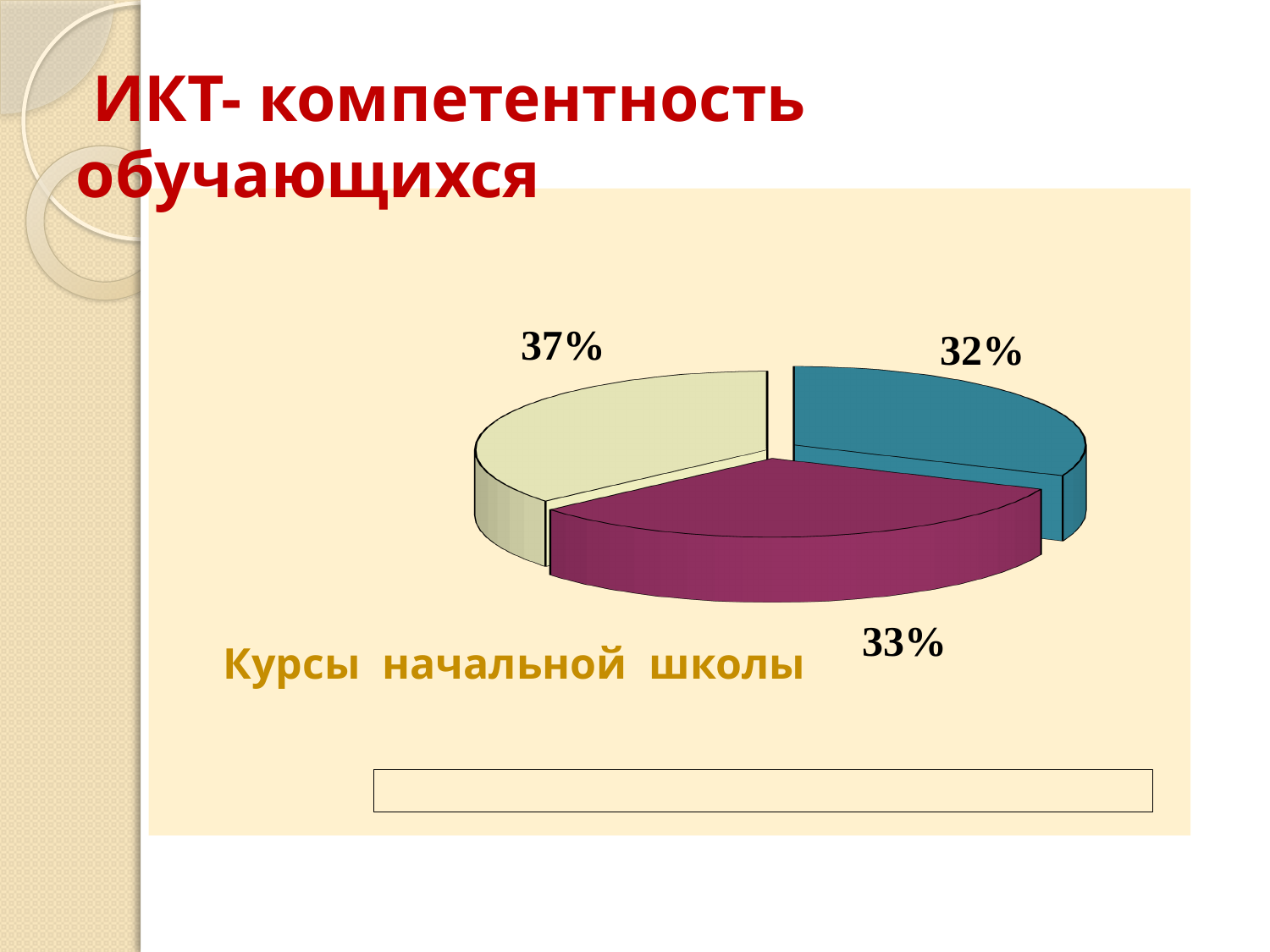
What is the difference between the magenta slice and the teal slice of the pie chart? 1% Which is larger in the pie chart: the cream slice or the magenta slice? the cream slice What is the title of the slide containing the pie chart? ИКТ- компетентность обучающихся How many slices does the pie chart have? 3 Which slice of the pie chart has the largest share? the light cream slice (37%) What is the difference between the largest and smallest slices of the pie chart? 5% Which slice of the pie chart has the smallest share? the teal slice (32%) What percentage is shown for the magenta (purple) slice of the pie chart? 33% What percentage is shown for the light cream slice of the pie chart? 37% What text label appears below the pie chart? Курсы начальной школы What kind of chart is shown on the slide? pie chart What percentage is shown for the teal (blue-green) slice of the pie chart? 32%